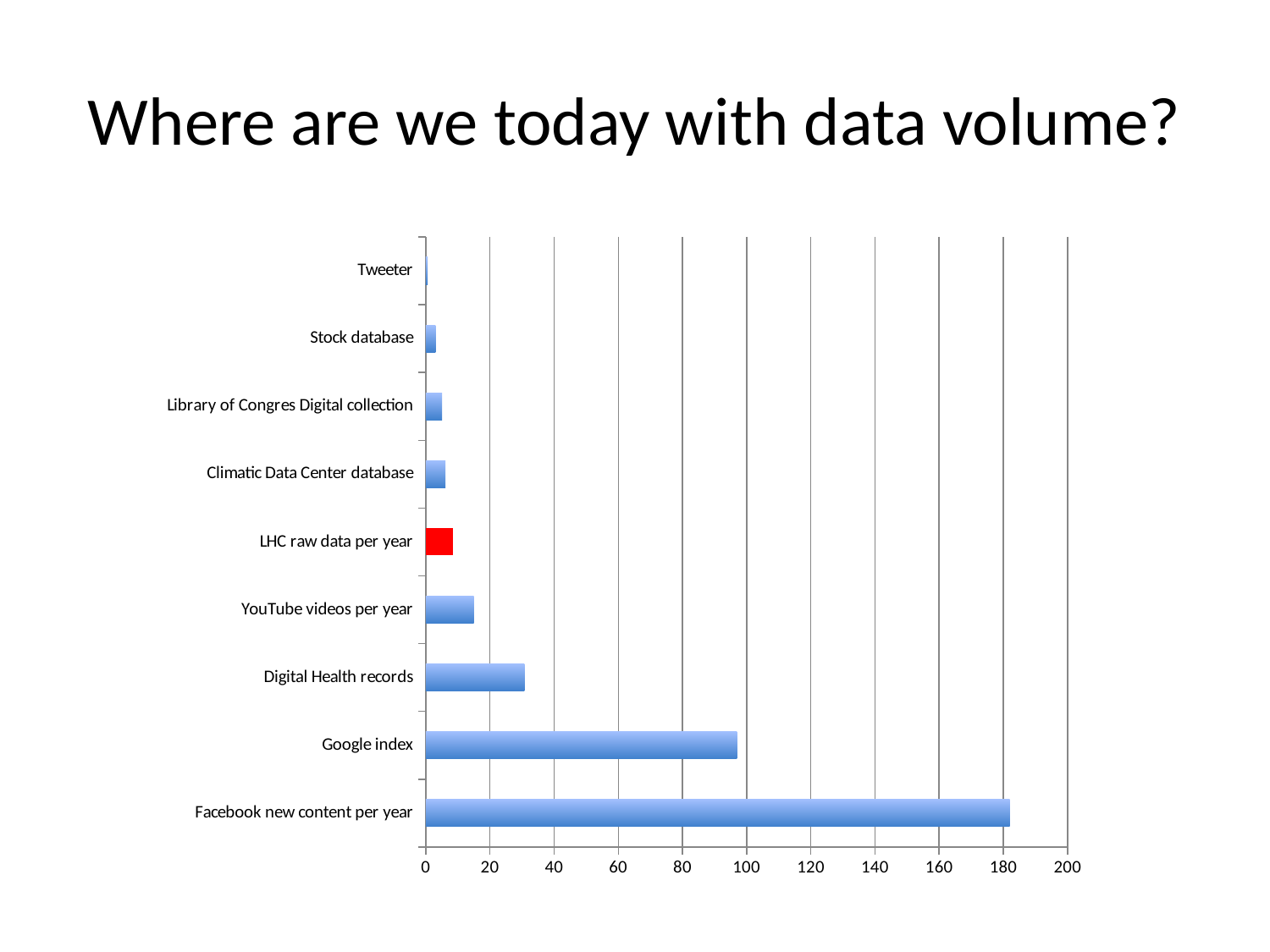
Is the value for Facebook new content per year greater or less than 160? greater How many categories are plotted in the chart? 9 Which category's bar is coloured red in the chart? LHC raw data per year Is the value for Digital Health records greater or less than 20? greater What kind of chart is shown on the slide? bar chart Which is larger, the value for YouTube videos per year or the value for LHC raw data per year? YouTube videos per year Which category has the lowest value in the chart? Tweeter Is the value for Google index greater or less than 100? less Which is larger, the value for Google index or the value for Digital Health records? Google index Which category has the highest value in the chart? Facebook new content per year What is the title of the slide containing the chart? Where are we today with data volume?